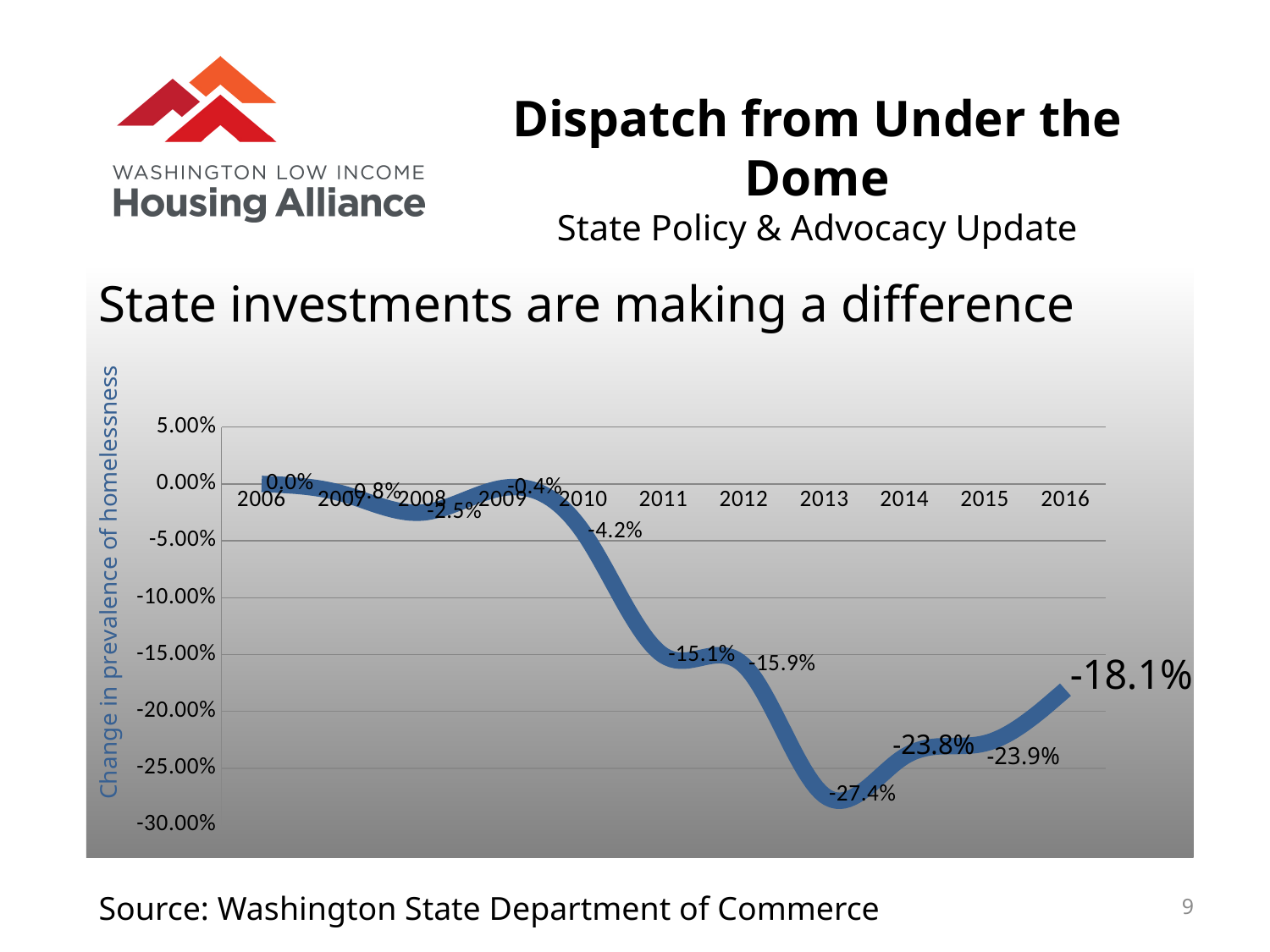
Which year has the highest value on the chart? 2006 What value is shown for 2011? -15.1% What is the difference between the values for 2013 and 2016? 9.3 percentage points What value is shown for 2006? 0.0% How many years are plotted on the chart? 11 Which year has the lowest value on the chart? 2013 What is the label on the vertical axis of the chart? Change in prevalence of homelessness What value is shown for 2010? -4.2% What is the change in prevalence of homelessness shown for 2016? -18.1% What value is shown for 2013? -27.4% What type of chart is shown on the slide? Line chart